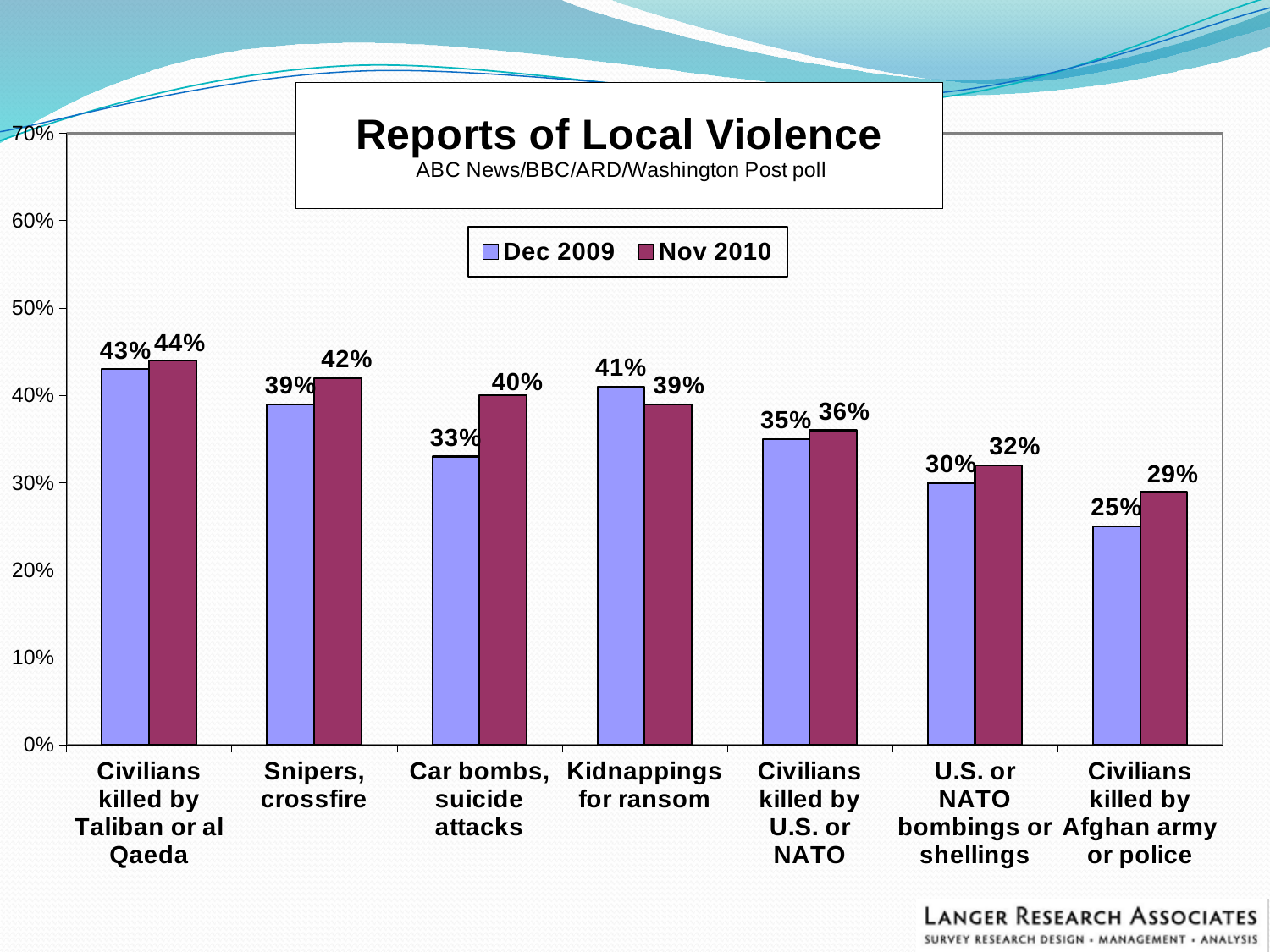
Which category has the lowest Dec 2009 value? Civilians killed by Afghan army or police What is the difference between the Nov 2010 and Dec 2009 values for Car bombs, suicide attacks? 7% What is the Nov 2010 value for Civilians killed by Afghan army or police? 29% What is the title of the chart? Reports of Local Violence How many categories are shown on the x axis? 7 How many series does the legend list? 2 Is the Dec 2009 value for U.S. or NATO bombings or shellings greater or less than 40%? less Which category has the highest Nov 2010 value? Civilians killed by Taliban or al Qaeda What is the Nov 2010 value for Car bombs, suicide attacks? 40% For Kidnappings for ransom, which is larger: the Dec 2009 value or the Nov 2010 value? Dec 2009 What kind of chart is shown on the slide? bar chart What is the Dec 2009 value for Kidnappings for ransom? 41%